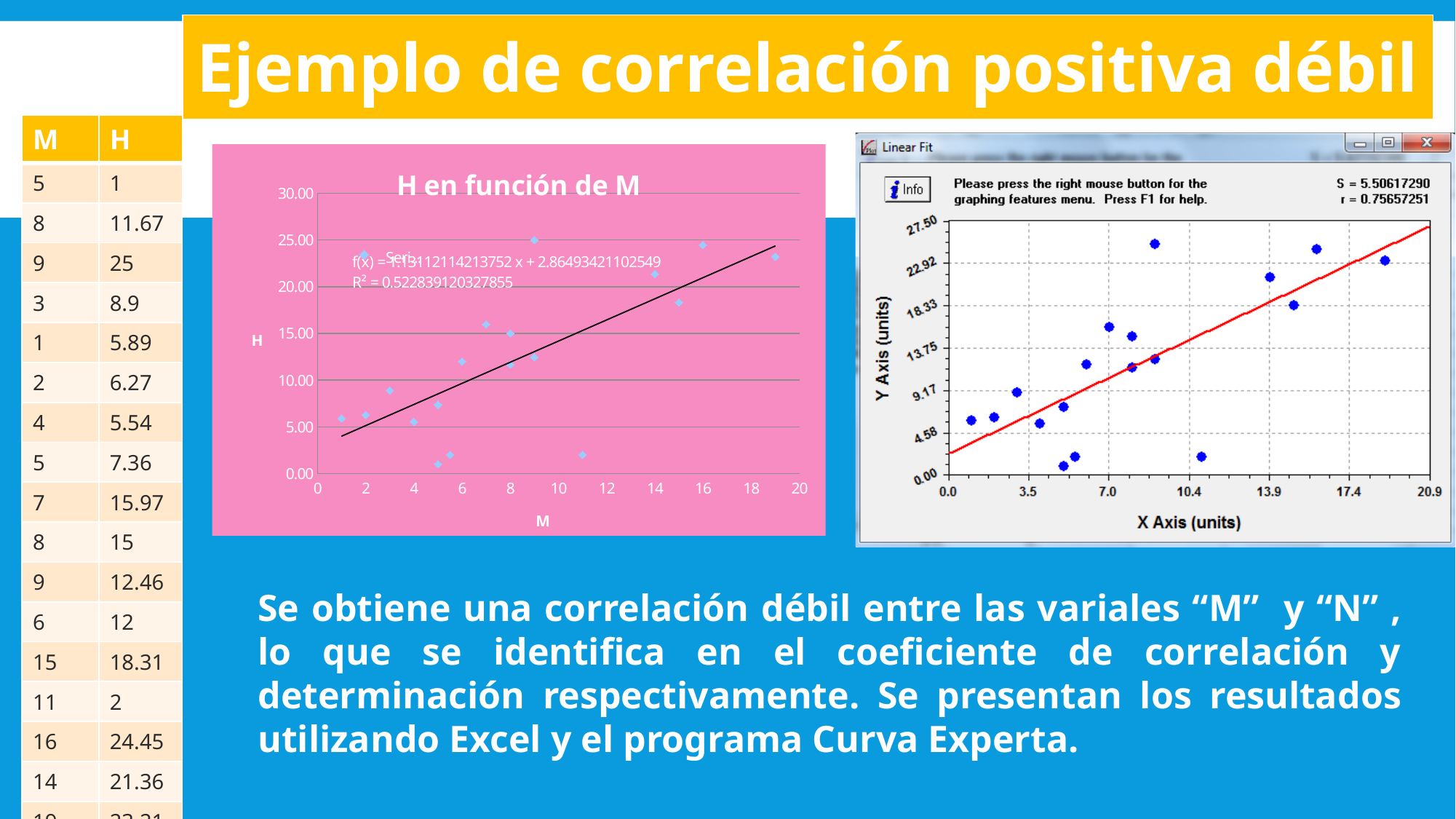
In the 'H en función de M' chart, is the H value of the point at M = 16 greater or less than 20.00? greater In the 'Linear Fit' chart on the right, does the red fitted line rise or fall along the x axis? rise In the 'H en función de M' chart, what R² value is printed on the chart? R² = 0.522839120327855 What kind of chart is the 'H en función de M' chart? scatter chart In the 'Linear Fit' chart on the right, what is the value of r shown? r = 0.75657251 In the 'H en función de M' chart, what is the slope of the fitted line f(x) shown on the chart? 1.13112114213752 What is the x-axis label of the 'Linear Fit' chart on the right? X Axis (units) In the 'H en función de M' chart, what is the intercept of the fitted line f(x) shown on the chart? 2.86493421102549 In the 'H en función de M' chart, do the values generally rise or fall as M increases? rise In the 'Linear Fit' chart on the right, what is the value of S shown? S = 5.50617290 In the 'H en función de M' chart, is the H value of the point at M = 11 greater or less than 5.00? less What is the title of the chart on the pink background? H en función de M